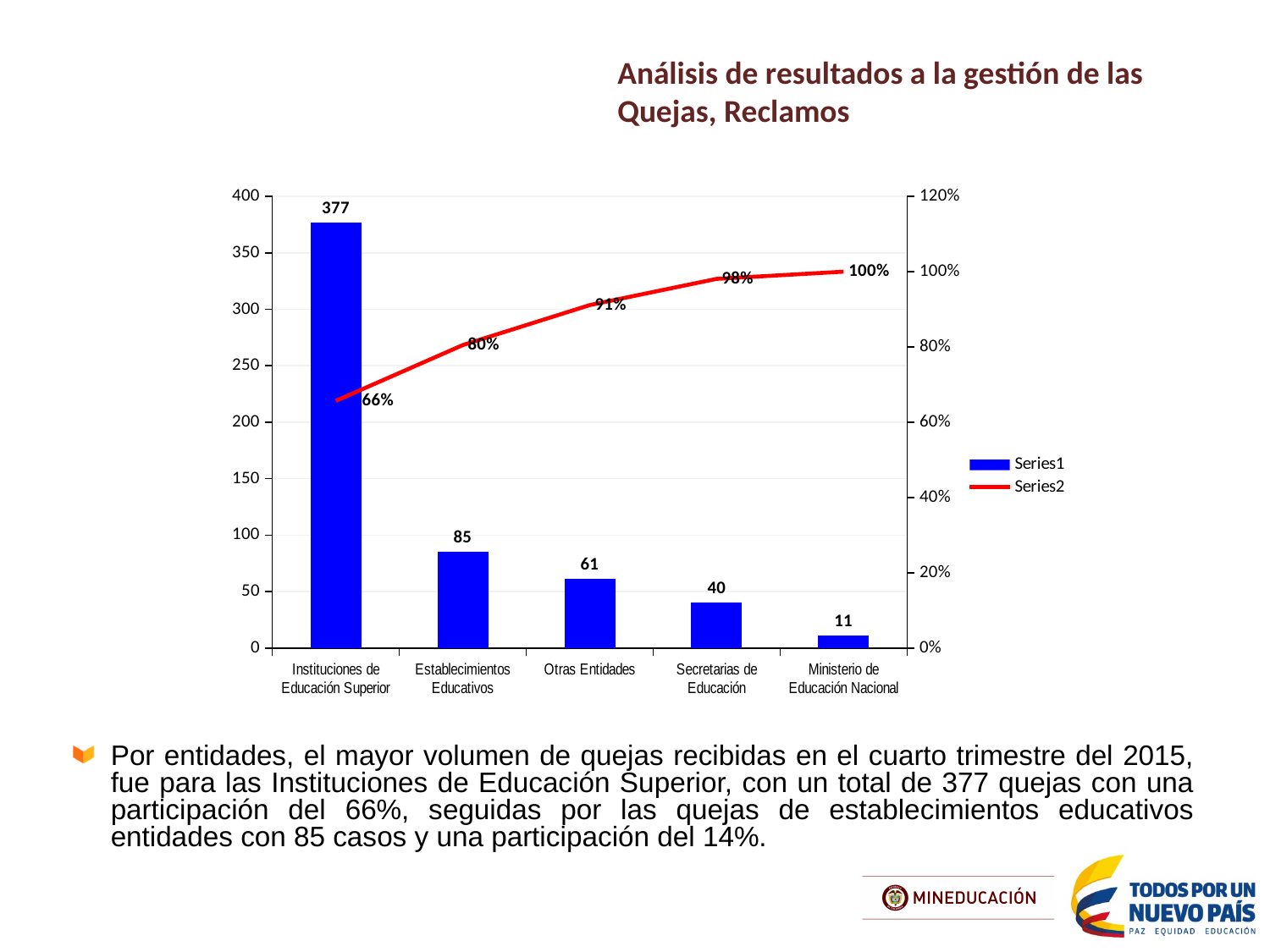
What is the difference between the Series1 values for Otras Entidades and Secretarias de Educación? 21 Which is larger, the Series1 value for Establecimientos Educativos or for Secretarias de Educación? Establecimientos Educativos What is the Series2 percentage for Ministerio de Educación Nacional? 100% What colour is the Series2 line? red What is the Series2 percentage for Otras Entidades? 91% Which category has the lowest Series1 value? Ministerio de Educación Nacional Which category has the highest Series1 value? Instituciones de Educación Superior How many series does the legend list? 2 What is the Series1 value for Establecimientos Educativos? 85 What is the Series1 value for Instituciones de Educación Superior? 377 Does the Series2 line rise or fall from left to right? rise How many categories are shown on the x axis? 5